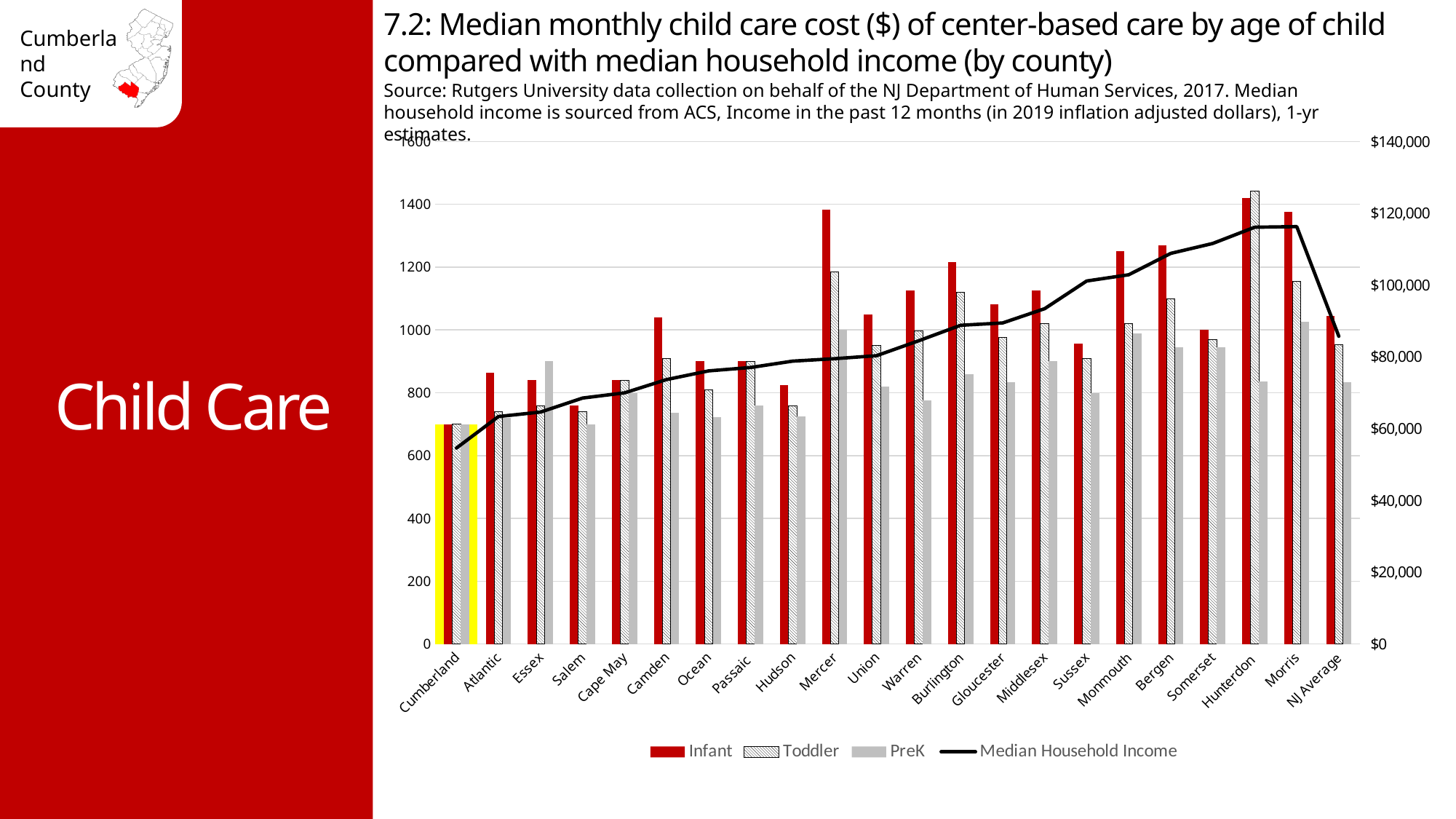
Which county has the lowest Infant bar? Cumberland Which is larger, the Infant value for Mercer or the Infant value for Camden? Mercer How many series does the chart's legend list? 4 Which county has the highest Toddler bar? Hunterdon Is the Median Household Income for Morris greater or less than $100,000? greater How many counties or categories are shown along the x axis of the chart? 22 Does the Median Household Income line generally rise or fall from Cumberland to Morris? rise Is the Infant value for Mercer greater or less than 1200? greater Is the Infant value for Cumberland greater or less than 800? less What kind of chart is shown on the slide? Bar chart with a line Which county's bars are highlighted in yellow on the chart? Cumberland